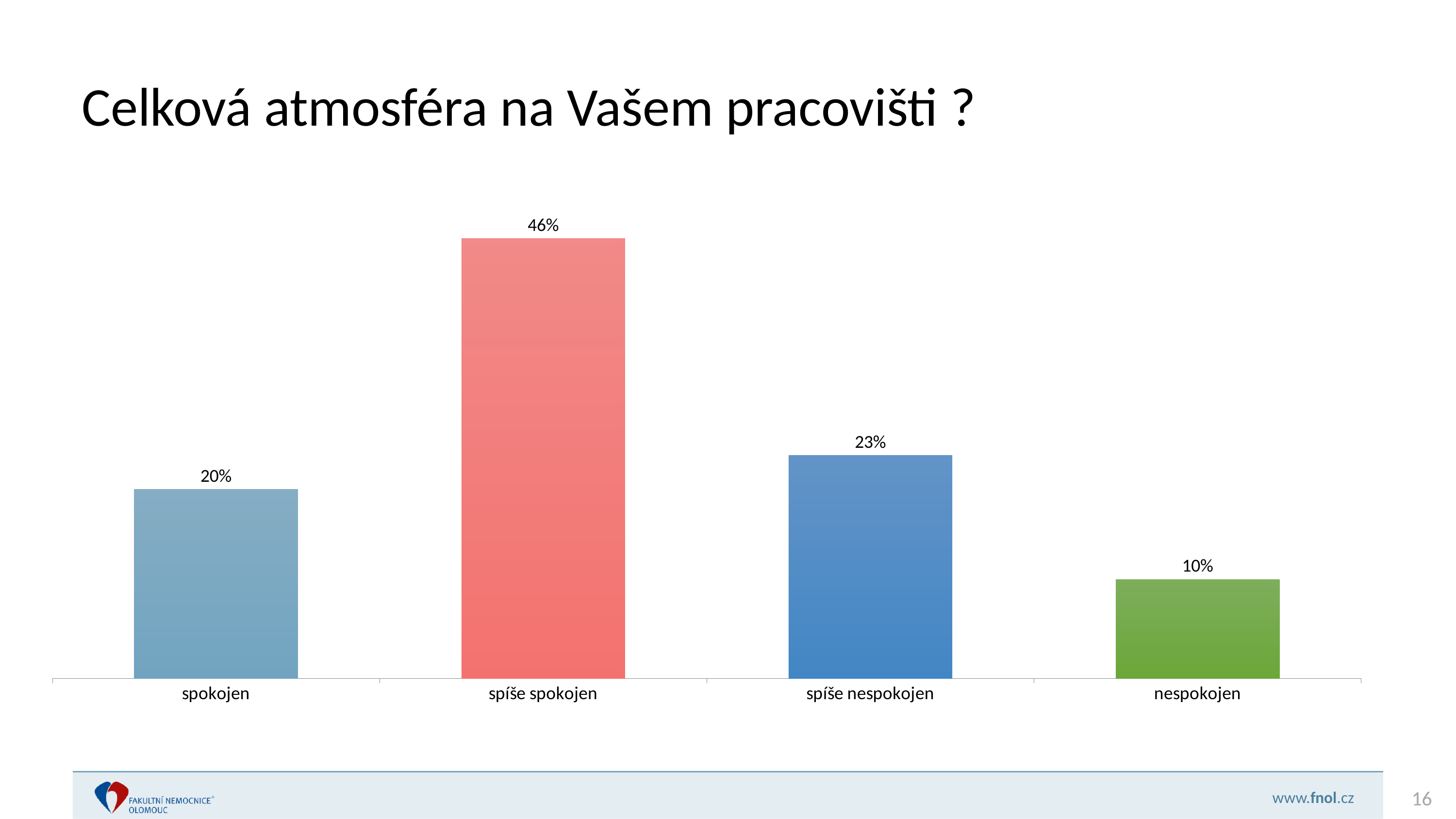
Which category has the lowest value? nespokojen What colour is the bar for spíše spokojen? red What is the value for spokojen? 20% How many categories are shown on the chart? 4 What is the value for nespokojen? 10% What kind of chart is shown on the slide? bar chart Which category has the highest value? spíše spokojen Which is larger, the value for spokojen or the value for spíše nespokojen? spíše nespokojen What is the value for spíše spokojen? 46% What is the title of the slide? Celková atmosféra na Vašem pracovišti ? What is the difference between the values for spíše spokojen and spíše nespokojen? 23% What is the value for spíše nespokojen? 23%